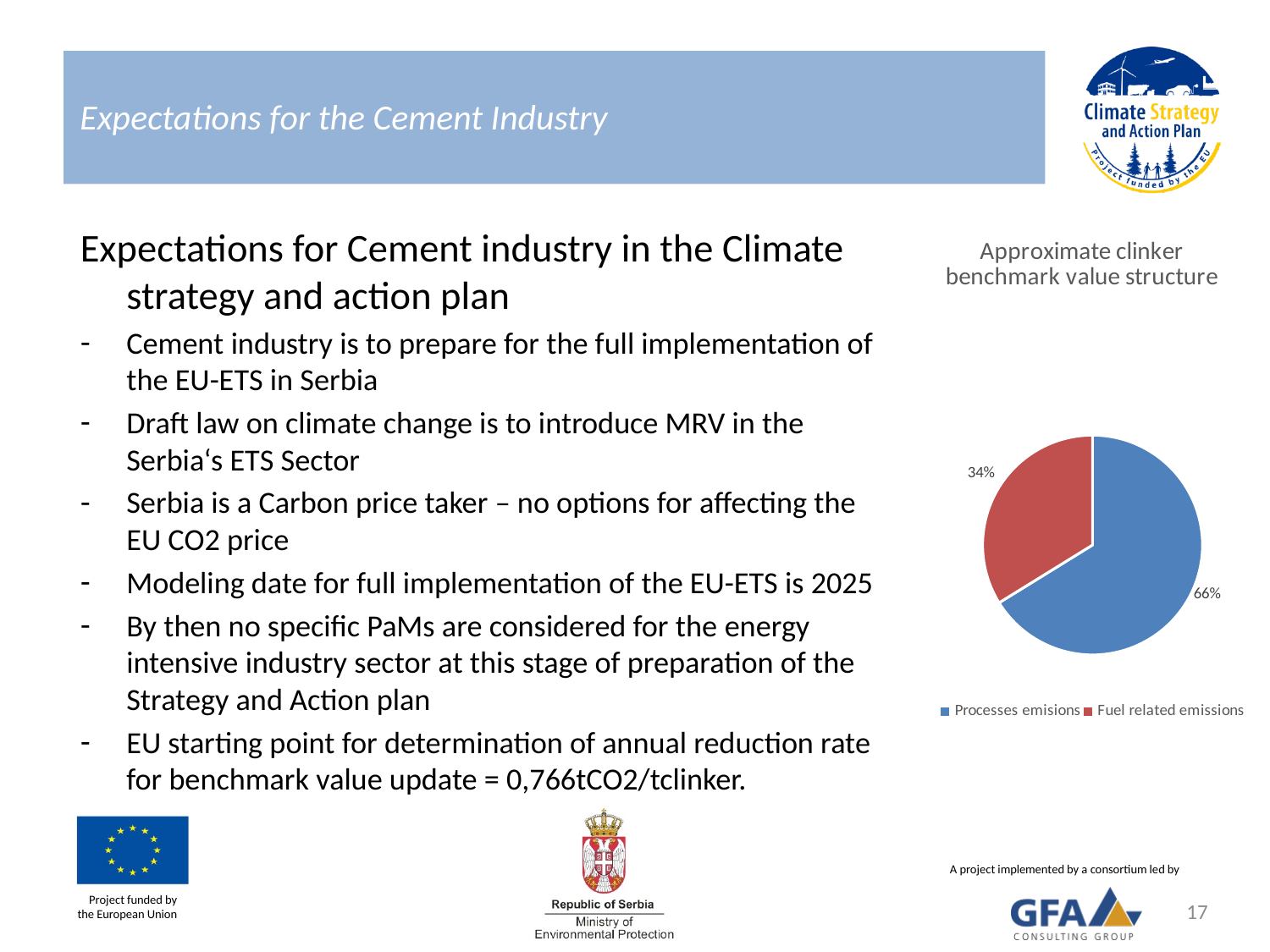
How many entries does the legend list? 2 What colour is the Fuel related emissions slice? red What type of chart is shown on the slide? pie chart What is the title of the chart? Approximate clinker benchmark value structure Which category has the smallest share of the pie? Fuel related emissions What is the difference in percentage points between Processes emisions and Fuel related emissions? 32 What share of the pie is Fuel related emissions? 34% What share of the pie is Processes emisions? 66% Which is larger, the share for Processes emisions or for Fuel related emissions? Processes emisions How many slices does the pie chart have? 2 Which category has the largest share of the pie? Processes emisions